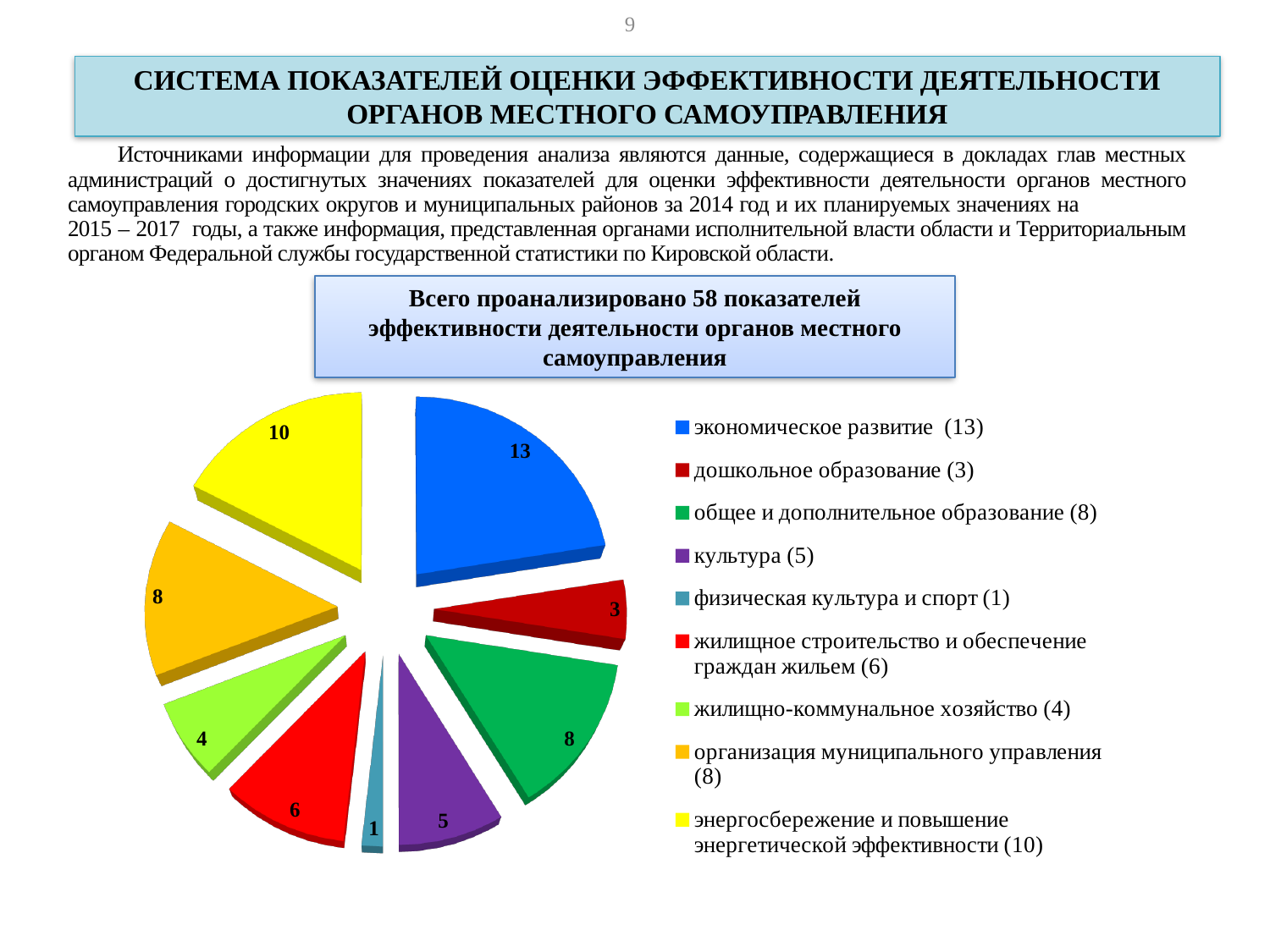
How many entries does the legend of the pie chart list? 9 What is the difference between the values for экономическое развитие and энергосбережение и повышение энергетической эффективности? 3 What is the value for экономическое развитие in the pie chart? 13 What colour is the slice for энергосбережение и повышение энергетической эффективности? yellow Which category has the smallest slice in the pie chart? физическая культура и спорт How many slices does the pie chart have? 9 What is the value for культура in the pie chart? 5 What is the total of all the slice values in the pie chart? 58 What is the value for физическая культура и спорт in the pie chart? 1 Which is larger: жилищное строительство и обеспечение граждан жильем or жилищно-коммунальное хозяйство? жилищное строительство и обеспечение граждан жильем Which category has the largest slice in the pie chart? экономическое развитие What kind of chart is shown on the slide? pie chart